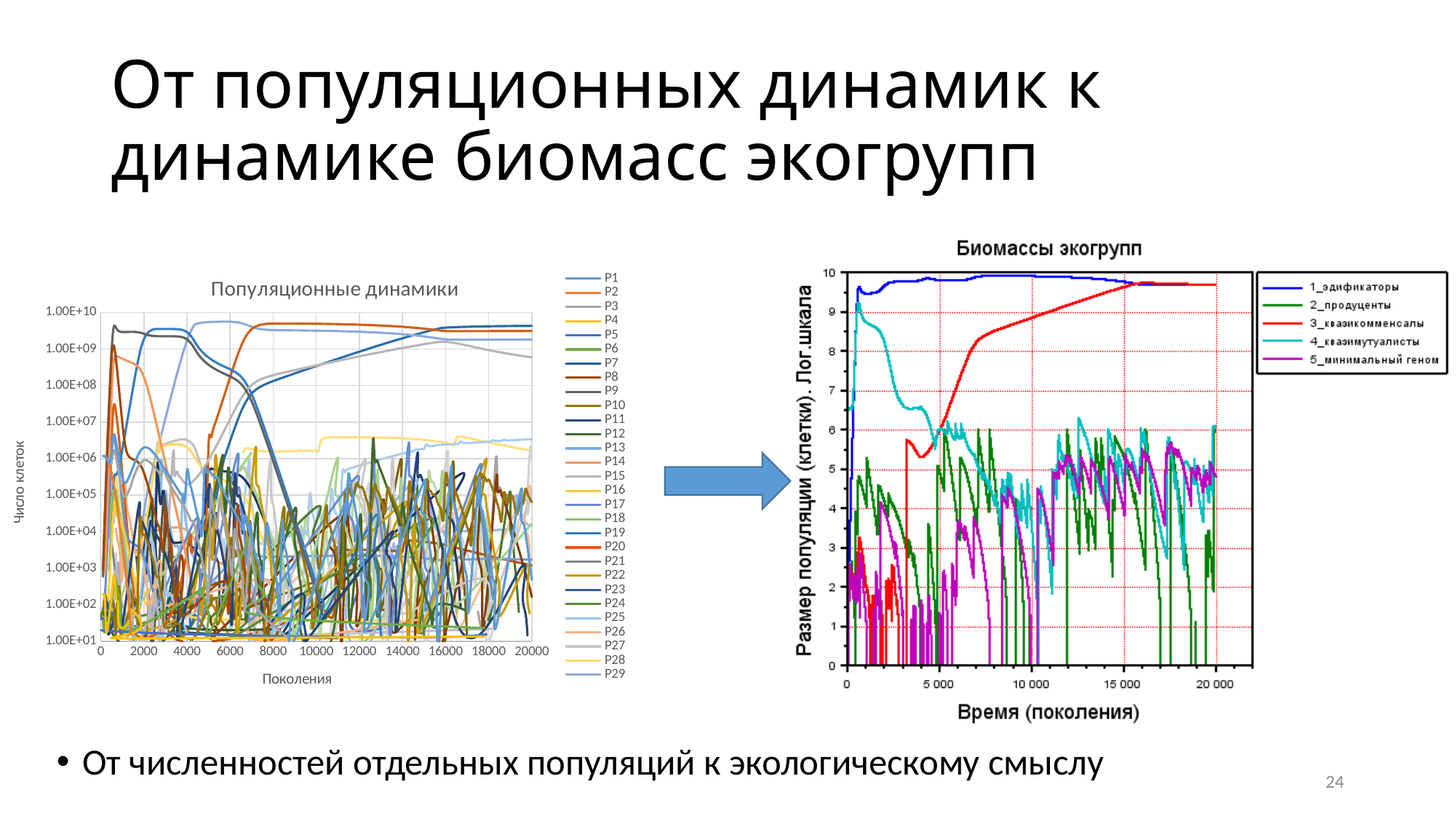
How many series does the legend of the left chart 'Популяционные динамики' list? 29 What is the title of the right chart? Биомассы экогрупп In the right chart 'Биомассы экогрупп', which is larger at 15 000 generations: 1_эдификаторы or 2_продуценты? 1_эдификаторы In the right chart 'Биомассы экогрупп', which series has the highest value at 10 000 generations? 1_эдификаторы In the right chart 'Биомассы экогрупп', does the series 3_квазикоменсалы rise or fall over time? rise How many series does the legend of the right chart 'Биомассы экогрупп' list? 5 What is the x-axis label of the right chart 'Биомассы экогрупп'? Время (поколения) In the right chart 'Биомассы экогрупп', is the value for 1_эдификаторы at 10 000 generations greater or less than 9? greater What kind of chart is the left chart titled 'Популяционные динамики'? line chart In the right chart 'Биомассы экогрупп', is the value for 3_квазикоменсалы at 5 000 generations greater or less than 8? less In the right chart 'Биомассы экогрупп', is the value for 2_продуценты at 15 000 generations greater or less than 8? less